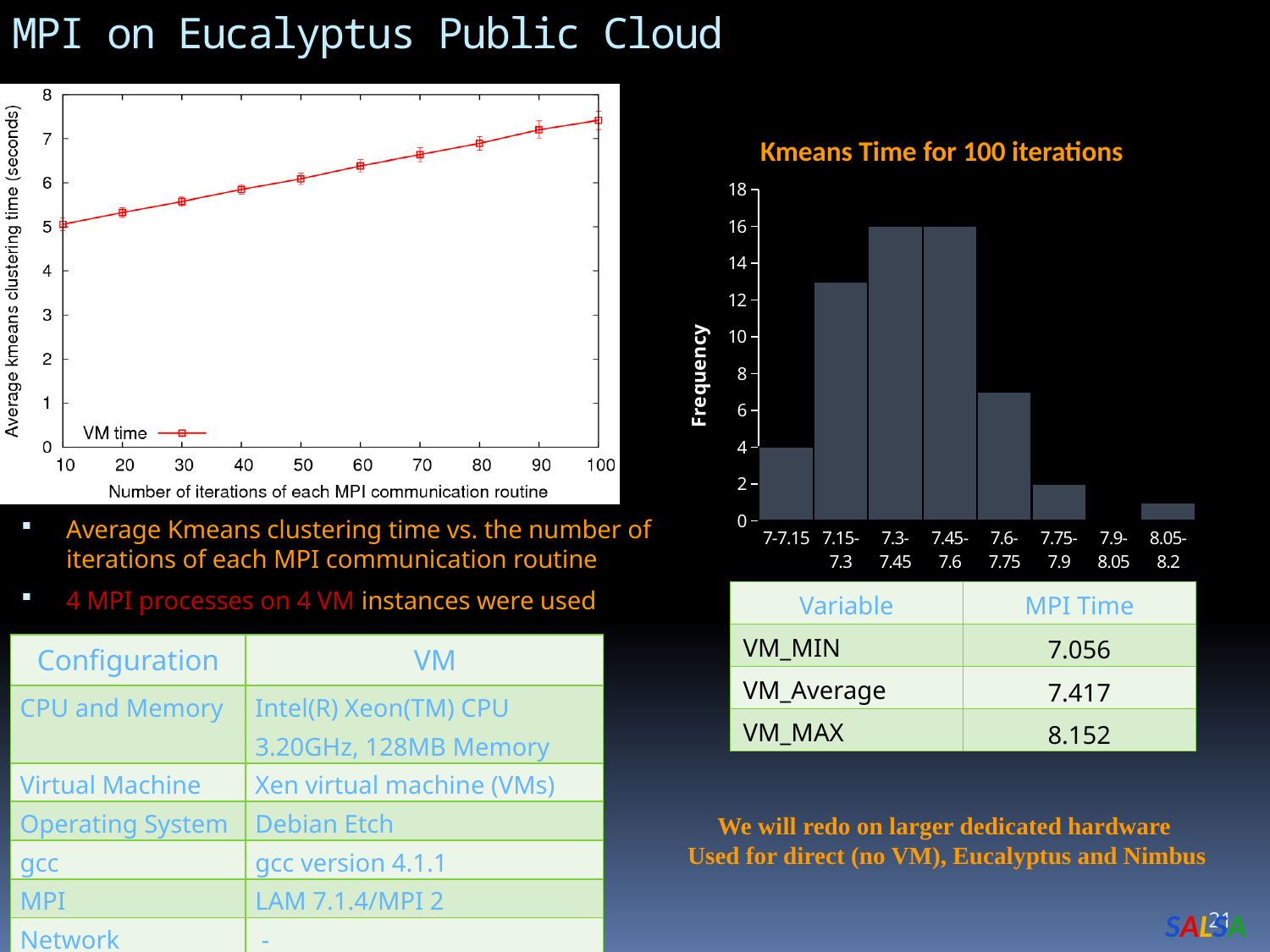
In the 'Kmeans Time for 100 iterations' chart, is the frequency for the 7.15-7.3 bin greater or less than 12? greater In the line chart on the left, what is the name of the series shown in the legend? VM time In the 'Kmeans Time for 100 iterations' chart, what is the frequency for the 7-7.15 bin? 4 In the 'Kmeans Time for 100 iterations' chart, how many bins are shown on the x axis? 8 What kind of chart is the 'Kmeans Time for 100 iterations' chart? bar chart In the line chart on the left, is the average kmeans clustering time at 100 iterations greater or less than 7 seconds? greater In the 'Kmeans Time for 100 iterations' chart, which bin has the lowest frequency? 7.9-8.05 In the 'Kmeans Time for 100 iterations' chart, what is the frequency for the 7.75-7.9 bin? 2 In the 'Kmeans Time for 100 iterations' chart, is the frequency for the 7.6-7.75 bin greater or less than 8? less In the line chart on the left, does the average kmeans clustering time rise or fall as the number of iterations increases? rises In the 'Kmeans Time for 100 iterations' chart, which has the higher frequency, the 7.15-7.3 bin or the 7.6-7.75 bin? 7.15-7.3 In the 'Kmeans Time for 100 iterations' chart, what is the frequency for the 7.3-7.45 bin? 16